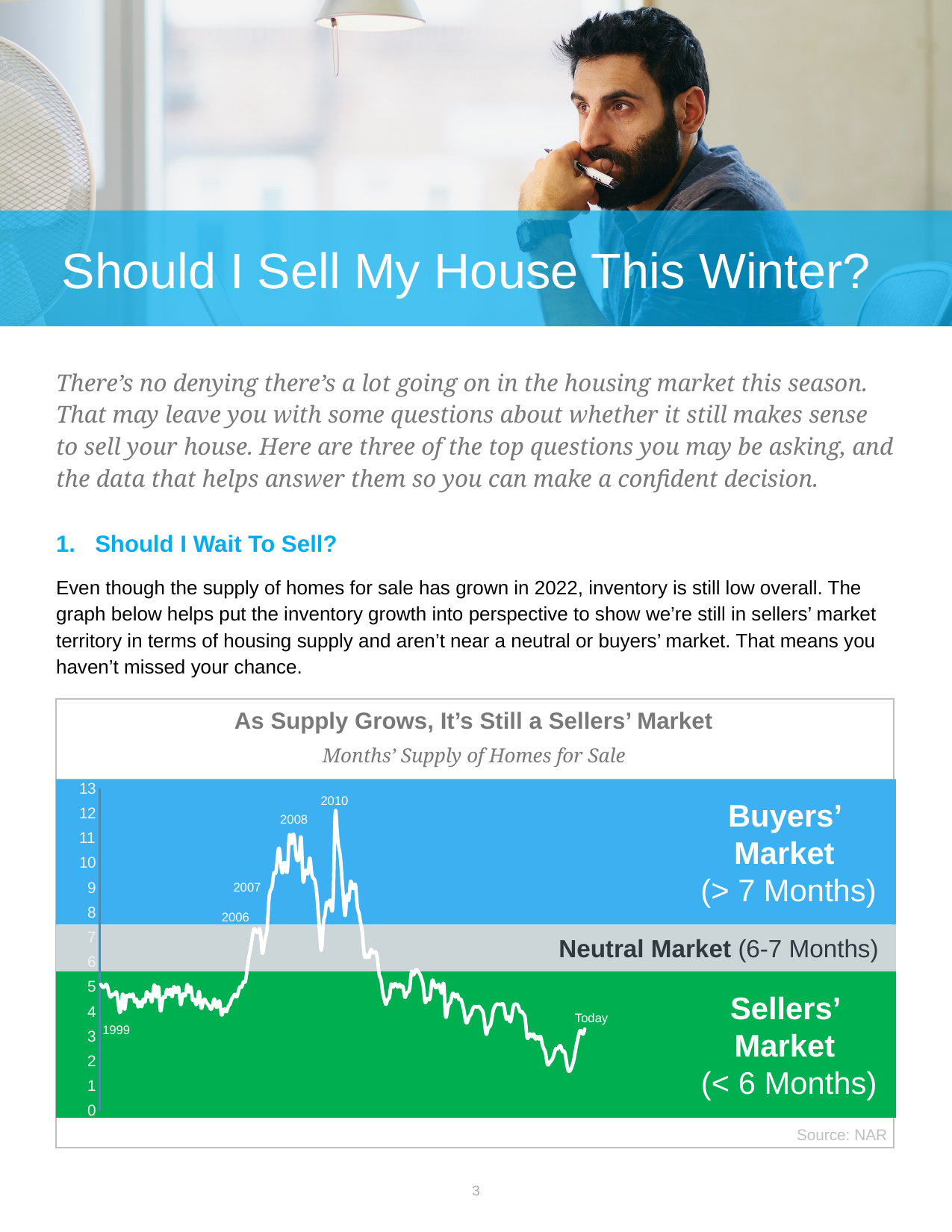
Is the value at the start of the line in 1999 greater or less than 6? less What kind of chart is shown on the slide? line chart What is the highest value shown on the y axis? 13 Which is larger, the value at the 2010 peak or the value at 'Today'? 2010 Which labeled year marks the highest point on the line? 2010 Is the value labeled 'Today' greater or less than 6? less Which market zone does the 'Today' point fall in? Sellers' Market What does the chart's subtitle say is being measured? Months' Supply of Homes for Sale Does the line rise or fall from the 2010 peak to 'Today'? fall Is the value labeled 2008 greater or less than 9? greater What is the title of the chart? As Supply Grows, It's Still a Sellers' Market